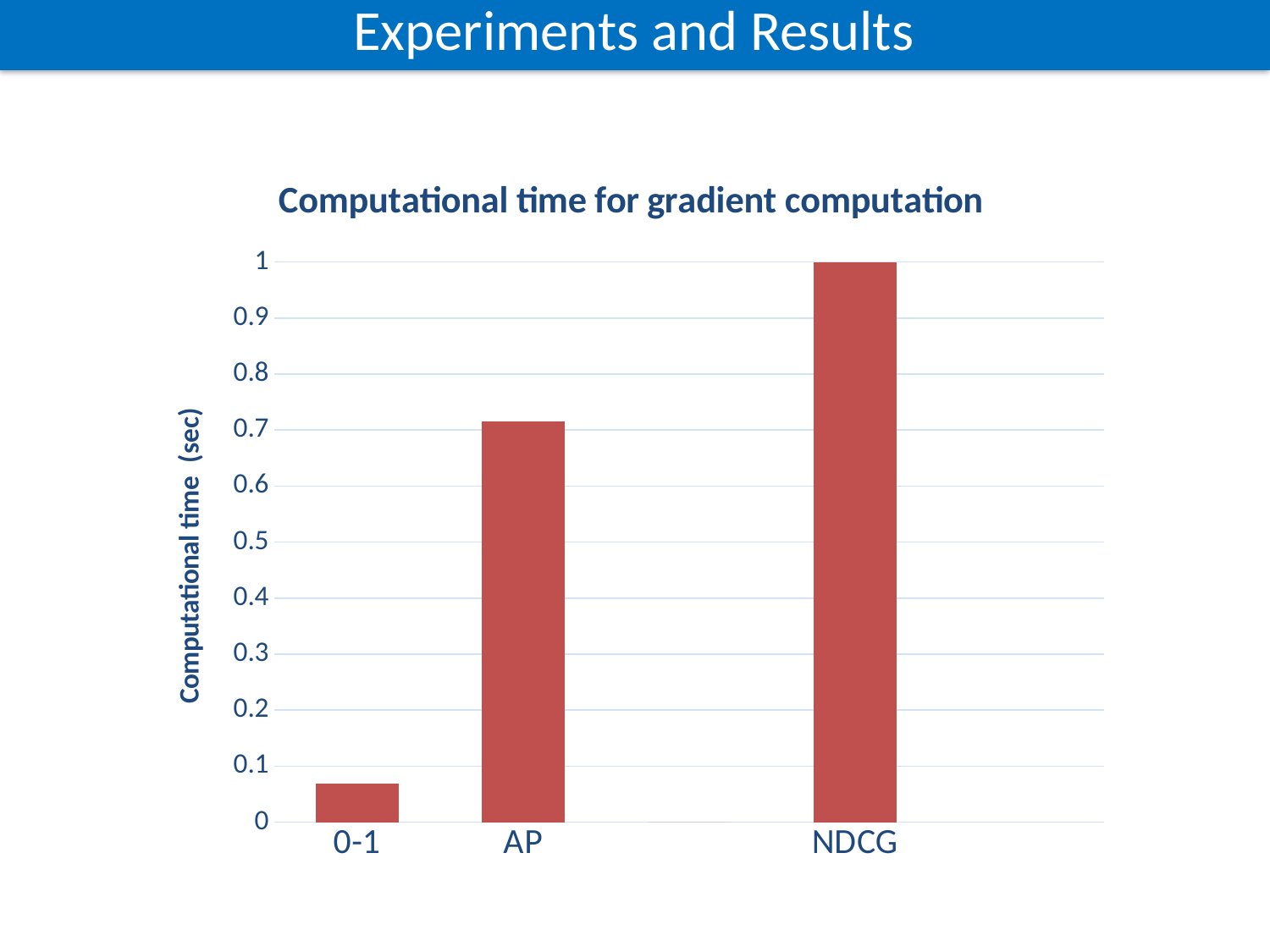
Which category has the lowest computational time? 0-1 Which has a larger computational time, AP or 0-1? AP What is the label of the vertical axis? Computational time (sec) Is the computational time for AP greater or less than 0.6? greater Do the values rise or fall moving from 0-1 to NDCG along the x axis? rise What kind of chart is shown on the slide? bar chart How many categories are plotted in the chart? 3 What is the title of the chart? Computational time for gradient computation Which category has the highest computational time? NDCG Is the computational time for 0-1 greater or less than 0.1? less Is the computational time for AP greater or less than 0.8? less